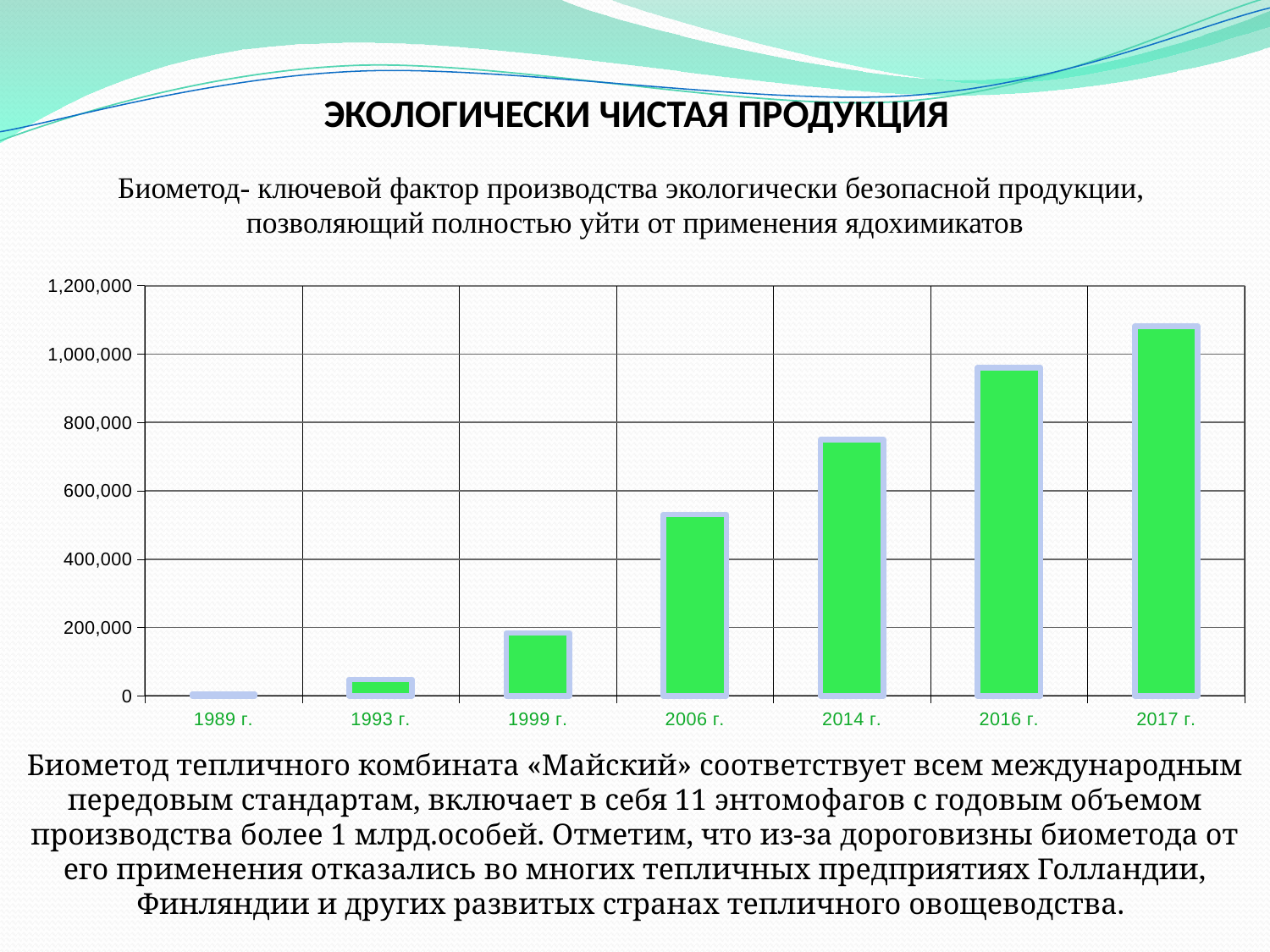
Is the value for 2017 г. greater or less than 1,000,000? greater How many years (categories) are shown on the x axis of the chart? 7 Do the values rise or fall from 1989 г. to 2017 г. along the x axis? rise Which is larger, the value for 2014 г. or the value for 2006 г.? 2014 г. Is the value for 2014 г. greater or less than 800,000? less What is the highest value shown on the y axis of the chart? 1,200,000 Is the value for 2016 г. greater or less than 800,000? greater What kind of chart is shown on the slide? bar chart Which year has the highest bar in the chart? 2017 г. Which year has the lowest bar in the chart? 1989 г.